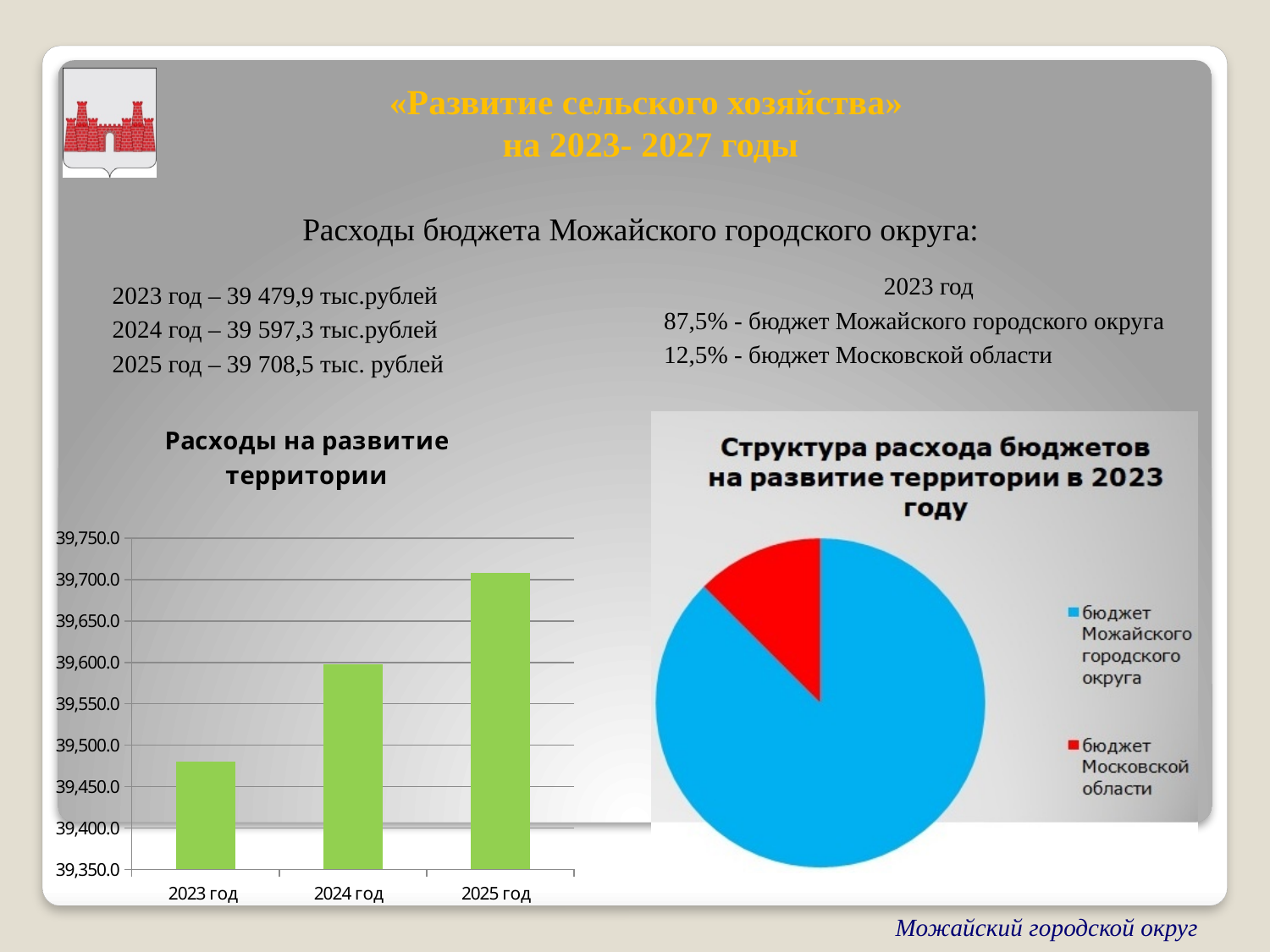
What kind of chart is the chart titled "Структура расхода бюджетов на развитие территории в 2023 году"? pie chart In the pie chart "Структура расхода бюджетов на развитие территории в 2023 году", what share does "бюджет Московской области" have according to the slide? 12,5% What kind of chart is the chart titled "Расходы на развитие территории"? bar chart In the bar chart "Расходы на развитие территории", how many categories are shown on the x axis? 3 In the pie chart "Структура расхода бюджетов на развитие территории в 2023 году", which colour represents "бюджет Можайского городского округа"? blue In the bar chart "Расходы на развитие территории", do the values rise or fall from 2023 to 2025? rise In the bar chart "Расходы на развитие территории", is the value for 2025 год greater or less than 39,650.0? greater In the pie chart "Структура расхода бюджетов на развитие территории в 2023 году", how many entries does the legend list? 2 In the bar chart "Расходы на развитие территории", which year has the highest bar? 2025 год In the bar chart "Расходы на развитие территории", is the value for 2023 год greater or less than 39,500.0? less In the bar chart "Расходы на развитие территории", which is larger, the value for 2024 год or the value for 2023 год? 2024 год In the bar chart "Расходы на развитие территории", which year has the lowest bar? 2023 год